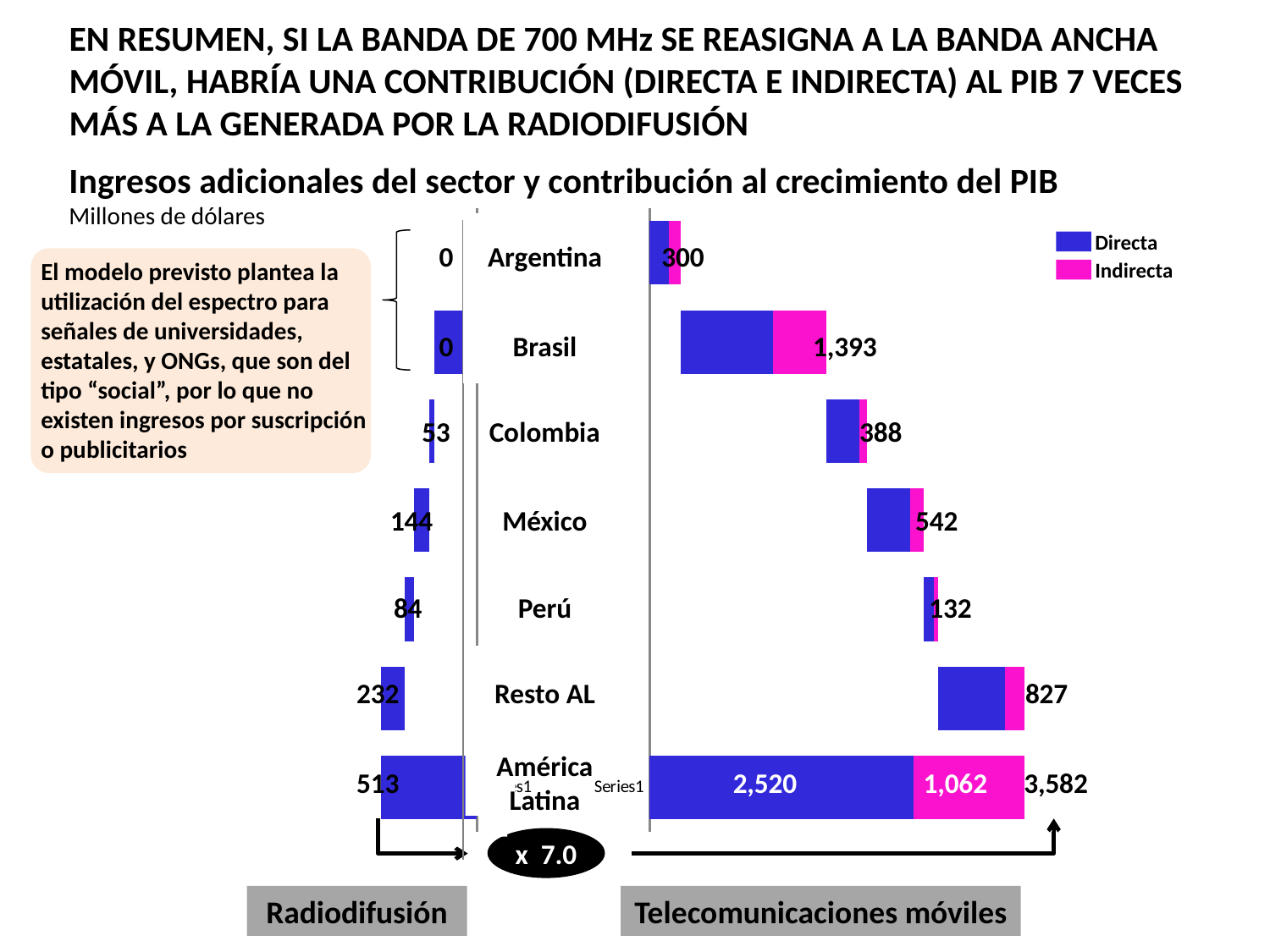
Among the individual countries (excluding Resto AL and América Latina), which has the highest Telecomunicaciones móviles value? Brasil What kind of chart is shown on the slide? Bar chart What is the Telecomunicaciones móviles value for Perú? 132 What is the Directa value for América Latina in the Telecomunicaciones móviles bar? 2,520 What is the Telecomunicaciones móviles value for Brasil? 1,393 What is the Radiodifusión value for Resto AL? 232 How many series does the legend list? 2 What is the total of the América Latina Telecomunicaciones móviles bar? 3,582 What is the difference between the Telecomunicaciones móviles value and the Radiodifusión value for México? 398 Among the individual countries, which has the lowest Telecomunicaciones móviles value? Perú What is the Radiodifusión value for México? 144 Which is larger: the Telecomunicaciones móviles value for Colombia or for México? México